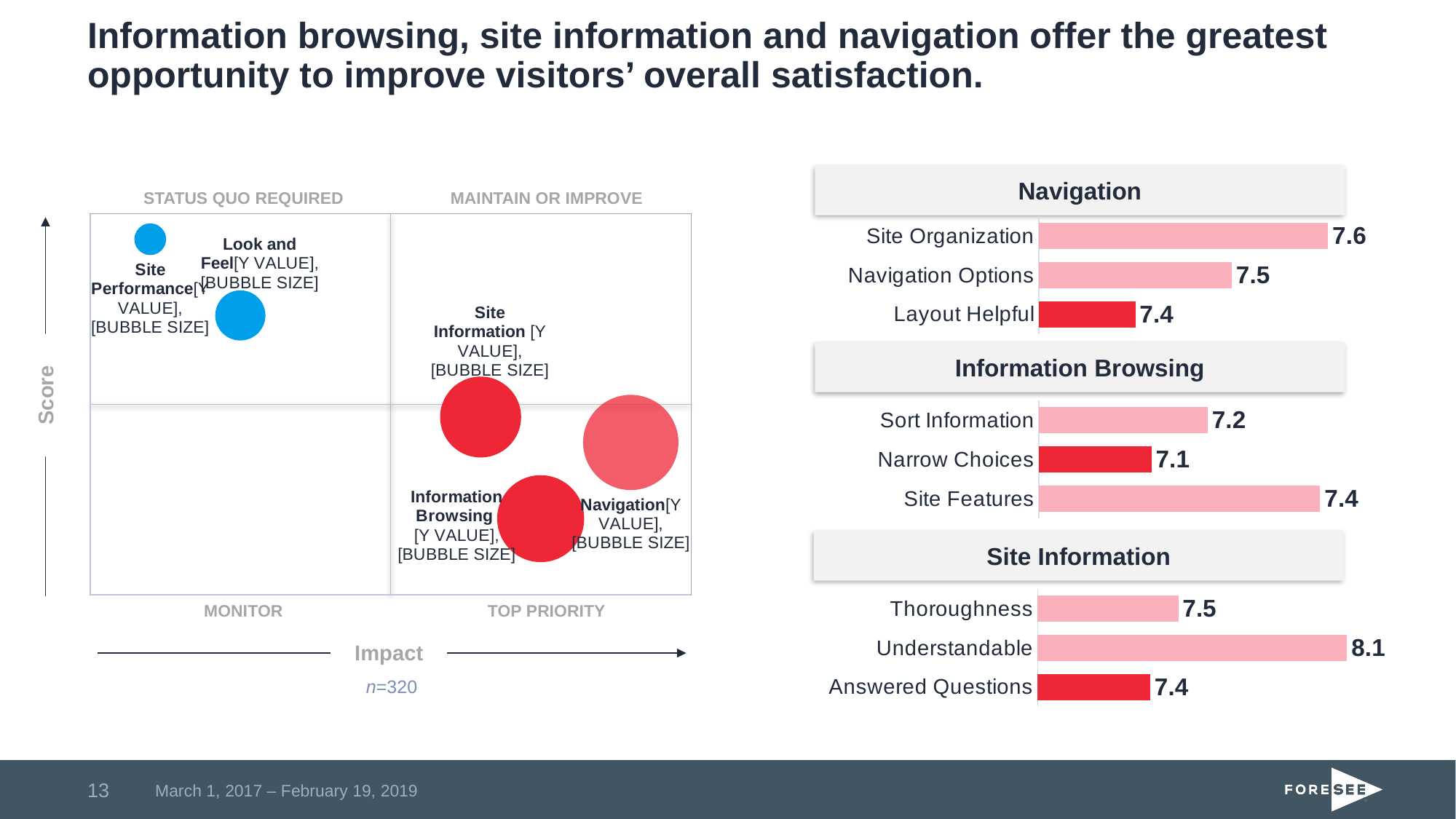
What kind of chart is the chart on the left of the slide with the Score and Impact axes? Bubble chart In the Navigation chart, what is the value for Site Organization? 7.6 In the Information Browsing chart, what is the value for Narrow Choices? 7.1 In the Site Information chart, which category has the highest value? Understandable In the Information Browsing chart, which category has the highest value? Site Features In the Information Browsing chart, what is the difference between Site Features and Narrow Choices? 0.3 In the Site Information chart, which is larger, Thoroughness or Answered Questions? Thoroughness In the Navigation chart, which category has the lowest value? Layout Helpful How many categories are shown in the Navigation chart? 3 In the Site Information chart, what is the difference between Understandable and Answered Questions? 0.7 In the Site Information chart, what is the value for Understandable? 8.1 How many bubbles are plotted in the bubble chart on the left of the slide? 5